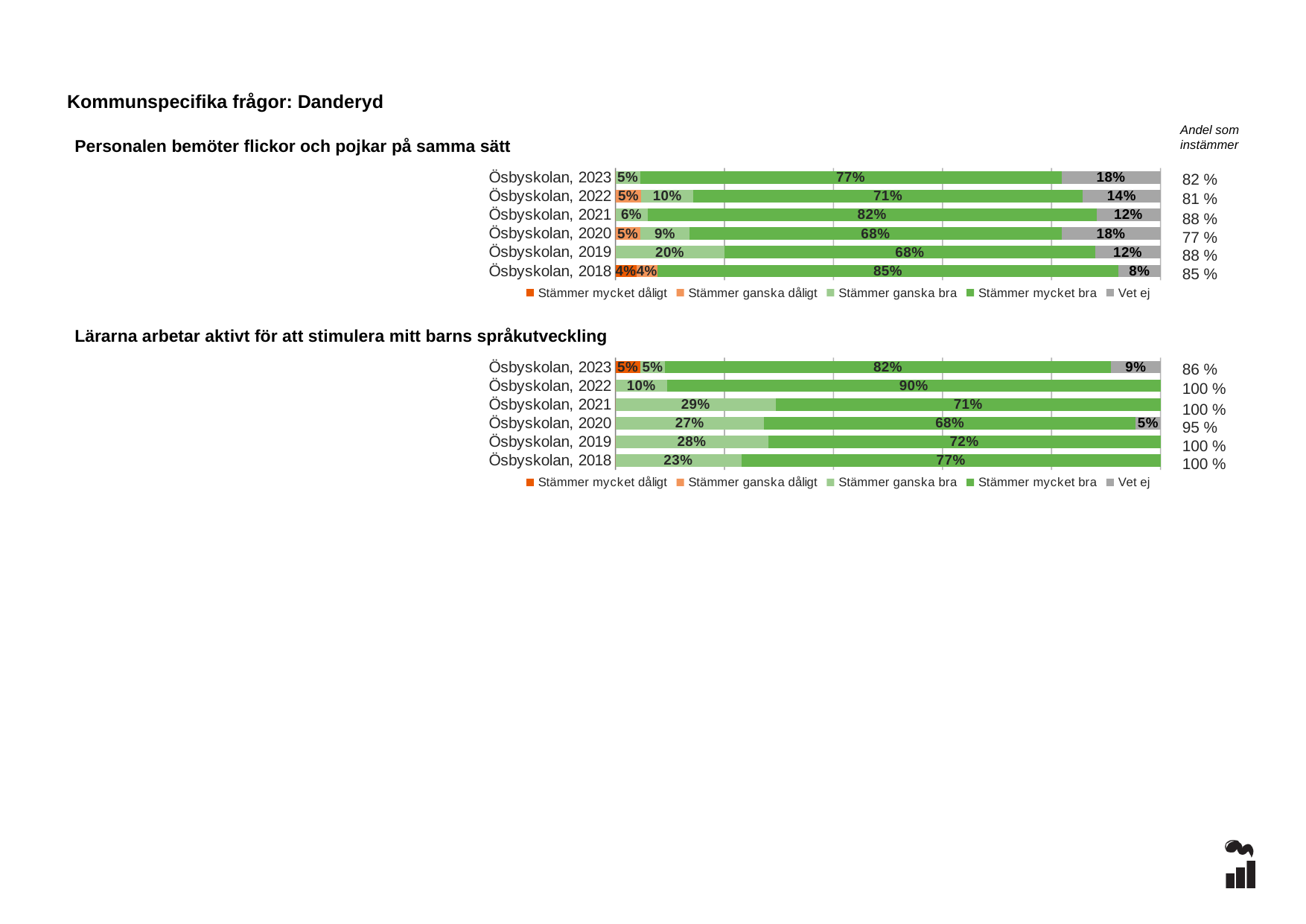
In the chart 'Personalen bemöter flickor och pojkar på samma sätt', what is the 'Vet ej' value for Ösbyskolan, 2020? 18% In the chart 'Lärarna arbetar aktivt för att stimulera mitt barns språkutveckling', is the 'Stämmer ganska bra' value larger for Ösbyskolan, 2019 or Ösbyskolan, 2018? Ösbyskolan, 2019 In the chart 'Personalen bemöter flickor och pojkar på samma sätt', what is the 'Stämmer mycket bra' value for Ösbyskolan, 2023? 77% In the chart 'Lärarna arbetar aktivt för att stimulera mitt barns språkutveckling', which year has the lowest 'Stämmer mycket bra' value? Ösbyskolan, 2020 In the chart 'Personalen bemöter flickor och pojkar på samma sätt', what is the difference between the 'Stämmer mycket bra' values for Ösbyskolan, 2021 and Ösbyskolan, 2022? 11% In the chart 'Personalen bemöter flickor och pojkar på samma sätt', which year has the highest 'Stämmer mycket bra' value? Ösbyskolan, 2018 In the chart 'Lärarna arbetar aktivt för att stimulera mitt barns språkutveckling', what is the 'Stämmer mycket bra' value for Ösbyskolan, 2022? 90% How many year categories are shown in the chart 'Personalen bemöter flickor och pojkar på samma sätt'? 6 In the chart 'Lärarna arbetar aktivt för att stimulera mitt barns språkutveckling', what is the difference between the 'Stämmer mycket bra' values for Ösbyskolan, 2022 and Ösbyskolan, 2023? 8% In the chart 'Lärarna arbetar aktivt för att stimulera mitt barns språkutveckling', what is the 'Stämmer ganska bra' value for Ösbyskolan, 2021? 29% What kind of chart is used for 'Personalen bemöter flickor och pojkar på samma sätt'? Stacked bar chart How many series does the legend of the chart 'Lärarna arbetar aktivt för att stimulera mitt barns språkutveckling' list? 5